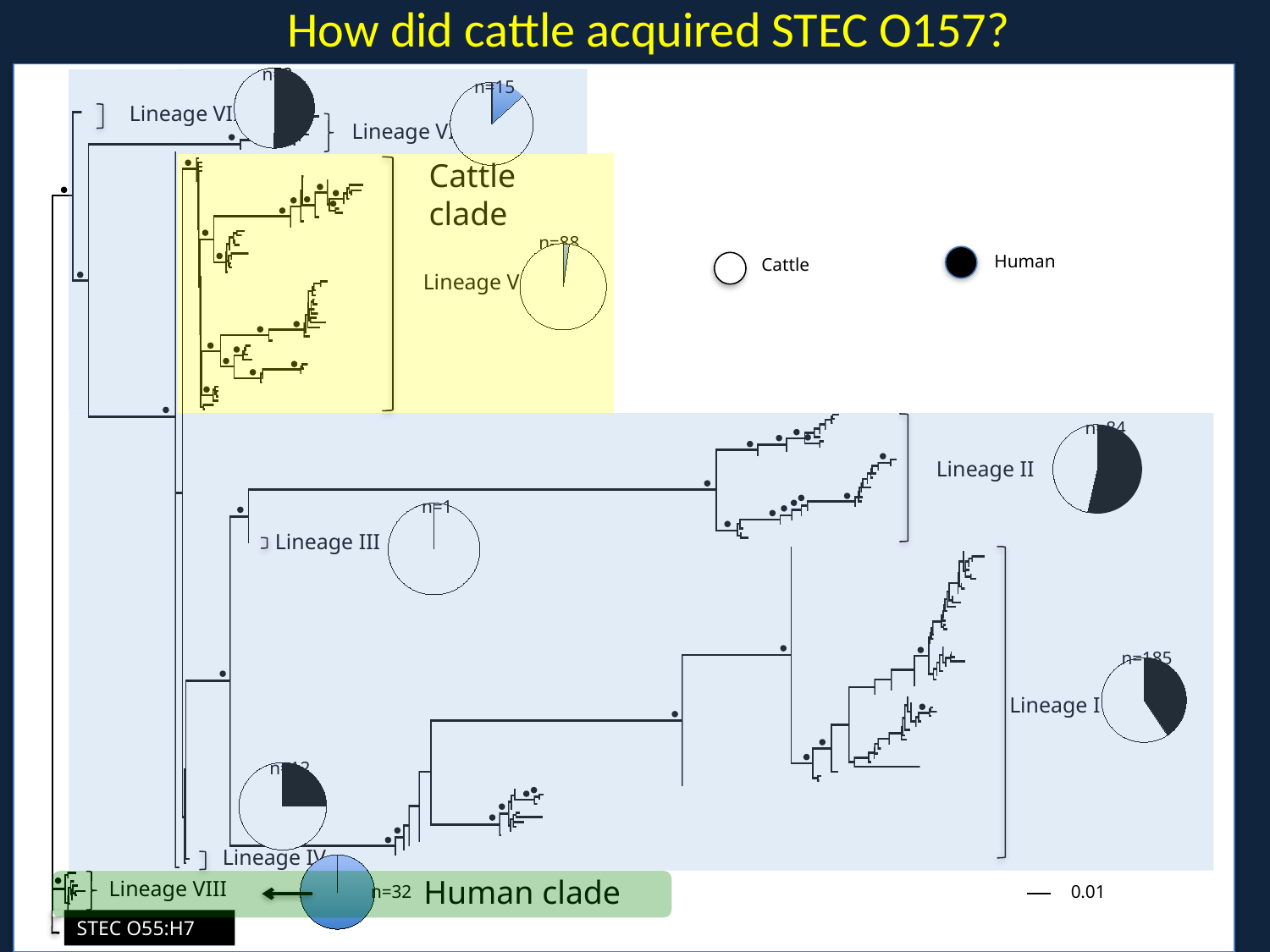
In the Lineage IV pie chart, which host category makes up the larger share, Cattle or Human? Cattle According to the legend, which two host categories do the pie charts distinguish? Cattle and Human Which lineage's pie chart has the smallest sample size among those labelled on the slide? Lineage III What is the sample size (n) shown for the Lineage V pie chart in the cattle clade? n=88 What is the sample size (n) shown for the Lineage VII pie chart? n=15 What kind of charts are overlaid on the phylogenetic tree on this slide? Pie charts In the Lineage V pie chart, which host category makes up the larger share, Cattle or Human? Cattle What is the sample size (n) shown for the Lineage VIII pie chart in the human clade? n=32 In the legend, which colour represents Human isolates? Black What is the sample size (n) shown for the Lineage III pie chart? n=1 Which lineage's pie chart has the largest sample size among those labelled on the slide? Lineage I What is the sample size (n) shown for the Lineage I pie chart? n=185